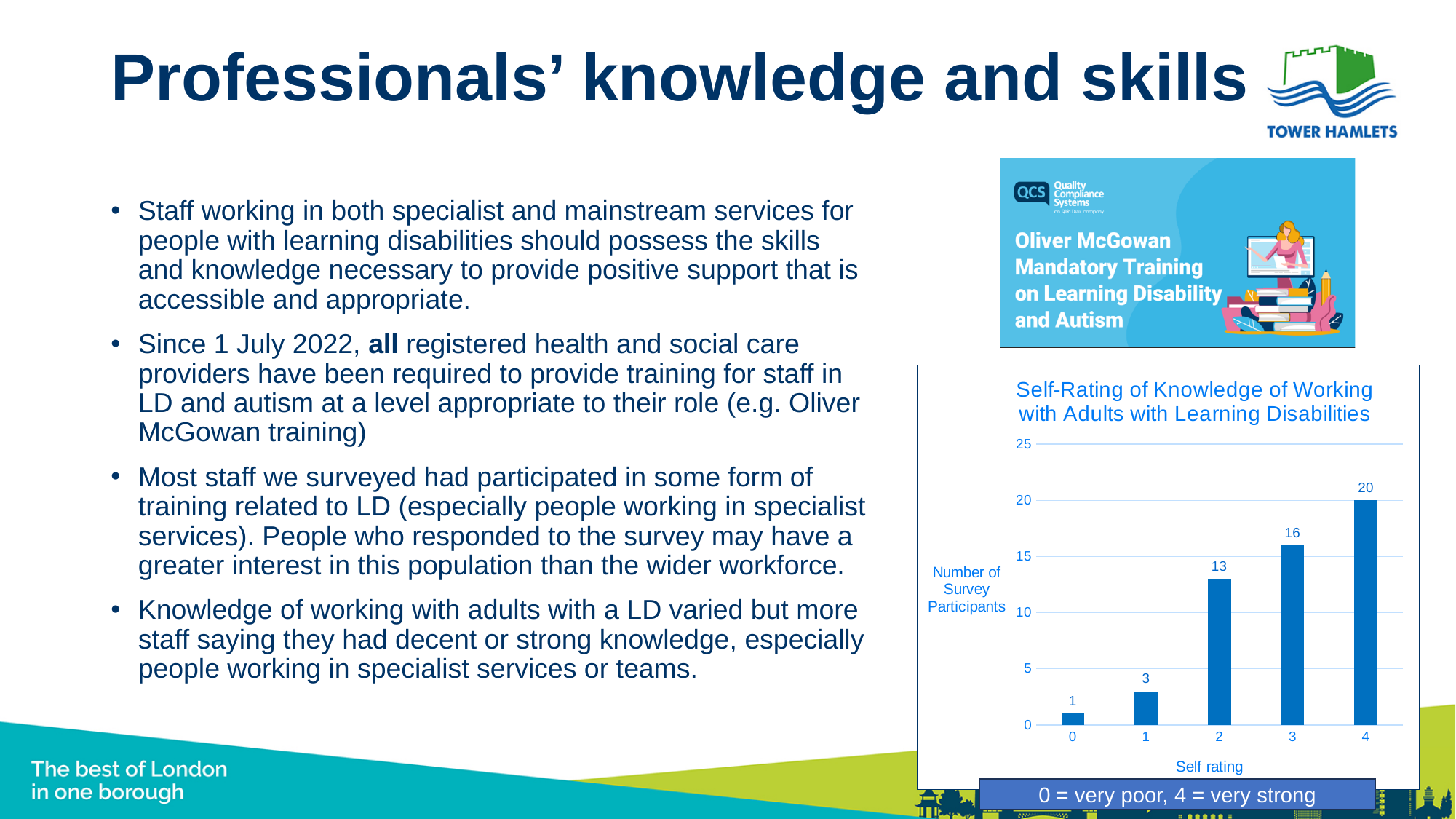
How many survey participants gave a self rating of 4? 20 How many survey participants gave a self rating of 0? 1 What is the title of the chart on the slide? Self-Rating of Knowledge of Working with Adults with Learning Disabilities Do the number of survey participants rise or fall as the self rating increases from 0 to 4? Rise What type of chart is used to show the self-rating of knowledge? Bar chart Which has more survey participants, self rating 1 or self rating 3? 3 How many self rating categories are shown on the x axis of the chart? 5 What is the difference in number of survey participants between self rating 2 and self rating 1? 10 How many survey participants gave a self rating of 2? 13 Which self rating has the highest number of survey participants? 4 Which self rating has the lowest number of survey participants? 0 What is the difference in number of survey participants between self rating 4 and self rating 3? 4